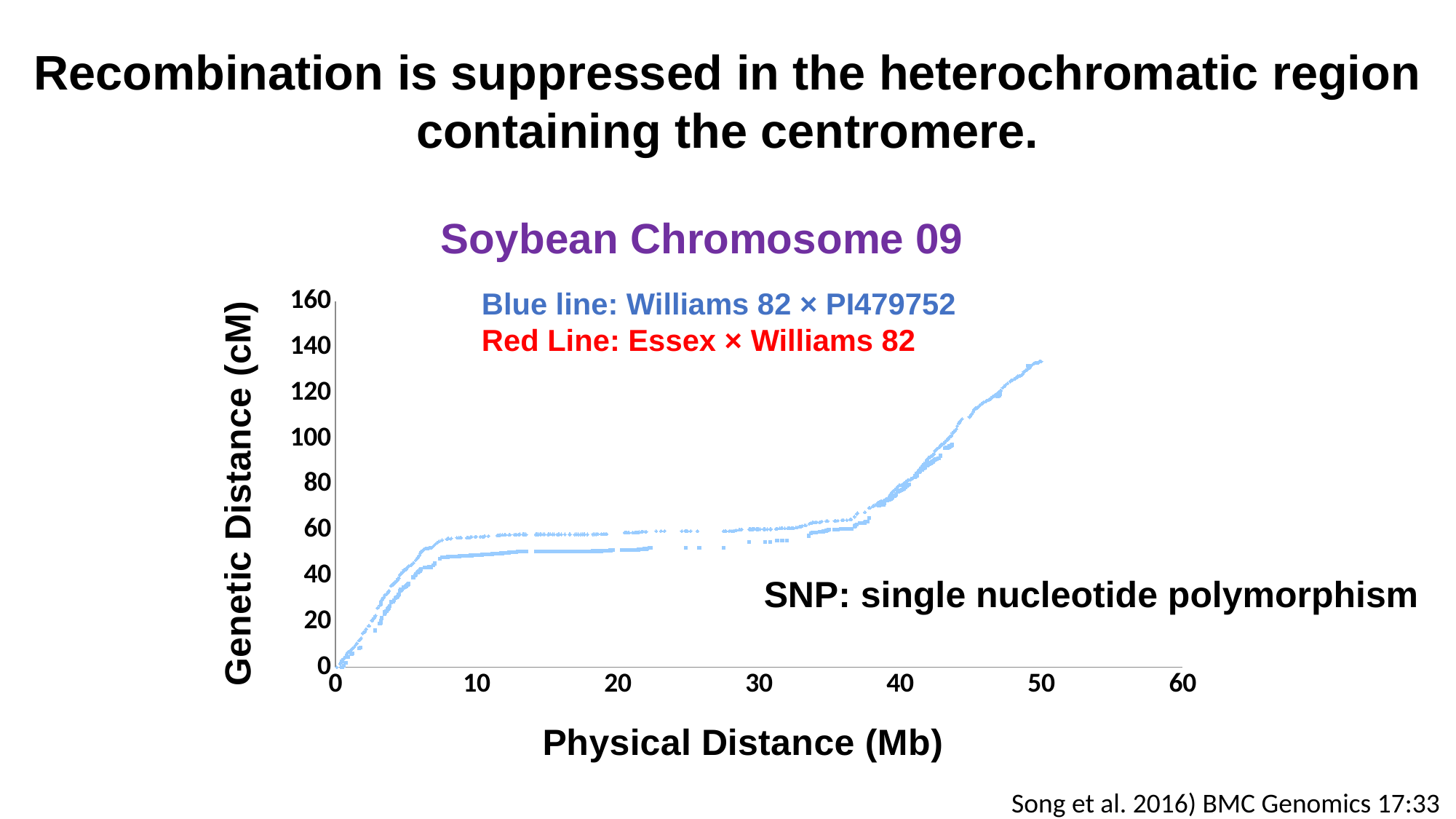
Is the genetic distance at a physical distance of 40 Mb greater or less than 100? less Is the genetic distance at a physical distance of 10 Mb greater or less than 80? less What is the highest tick value shown on the y axis? 160 What is the label of the x axis? Physical Distance (Mb) Is the genetic distance at a physical distance of 50 Mb greater or less than 120? greater How many lines (series) does the chart's legend text describe? 2 What is the title of the chart? Soybean Chromosome 09 Overall, does genetic distance rise or fall as physical distance increases along the x axis? rise What kind of chart is shown on the slide? line chart